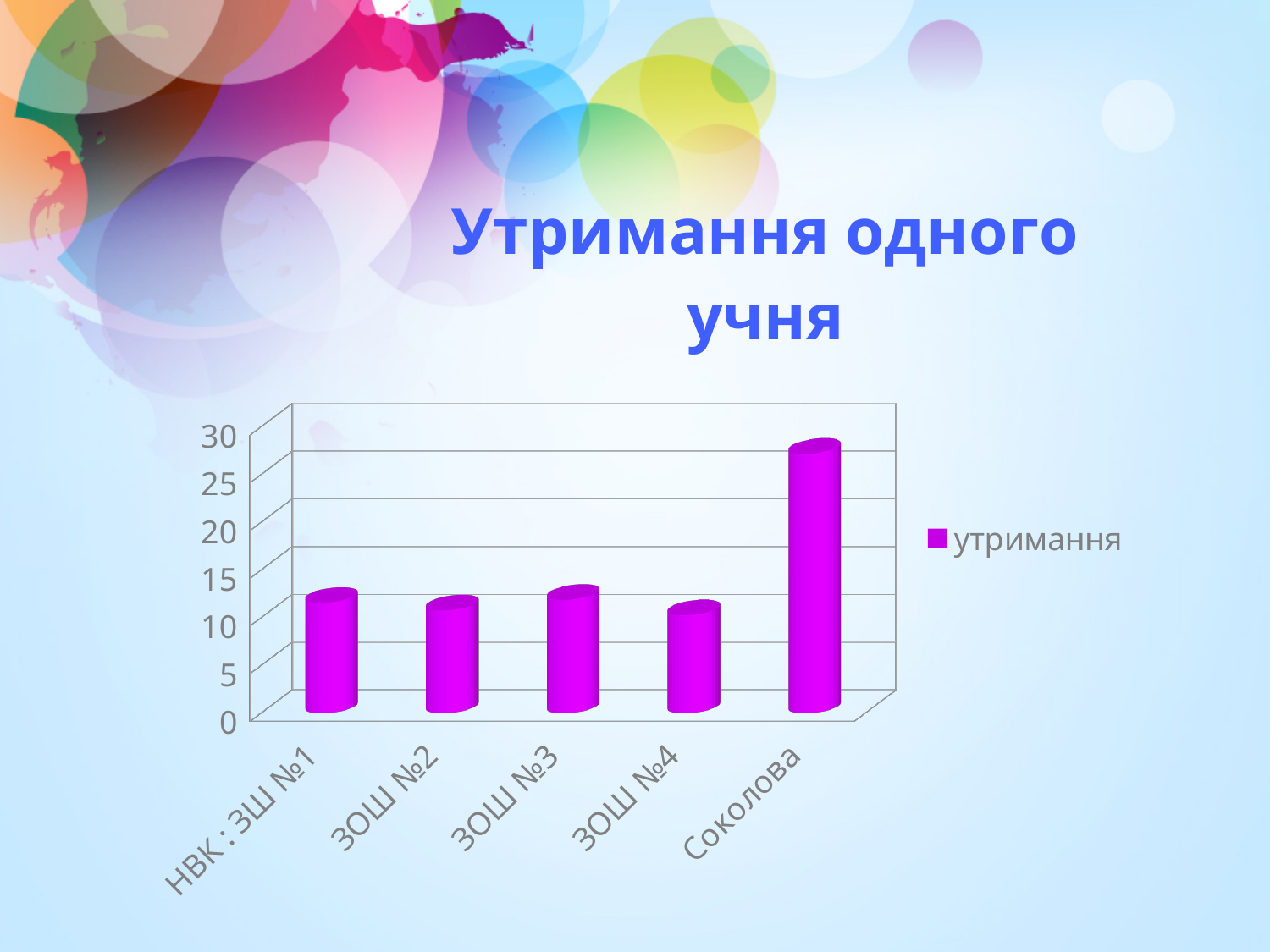
Is the value for НВК : ЗШ №1 greater or less than 5? greater What kind of chart is shown on the slide? bar chart What is the name of the series shown in the legend? утримання How many categories are shown on the x axis of the chart? 5 Is the value for Соколова greater or less than 25? greater How many series does the chart's legend list? 1 Is the value for Соколова greater or less than 30? less Which has the larger value, ЗОШ №3 or Соколова? Соколова Which has the larger value, Соколова or ЗОШ №2? Соколова Which category has the highest value in the chart? Соколова What is the title of the chart on the slide? Утримання одного учня